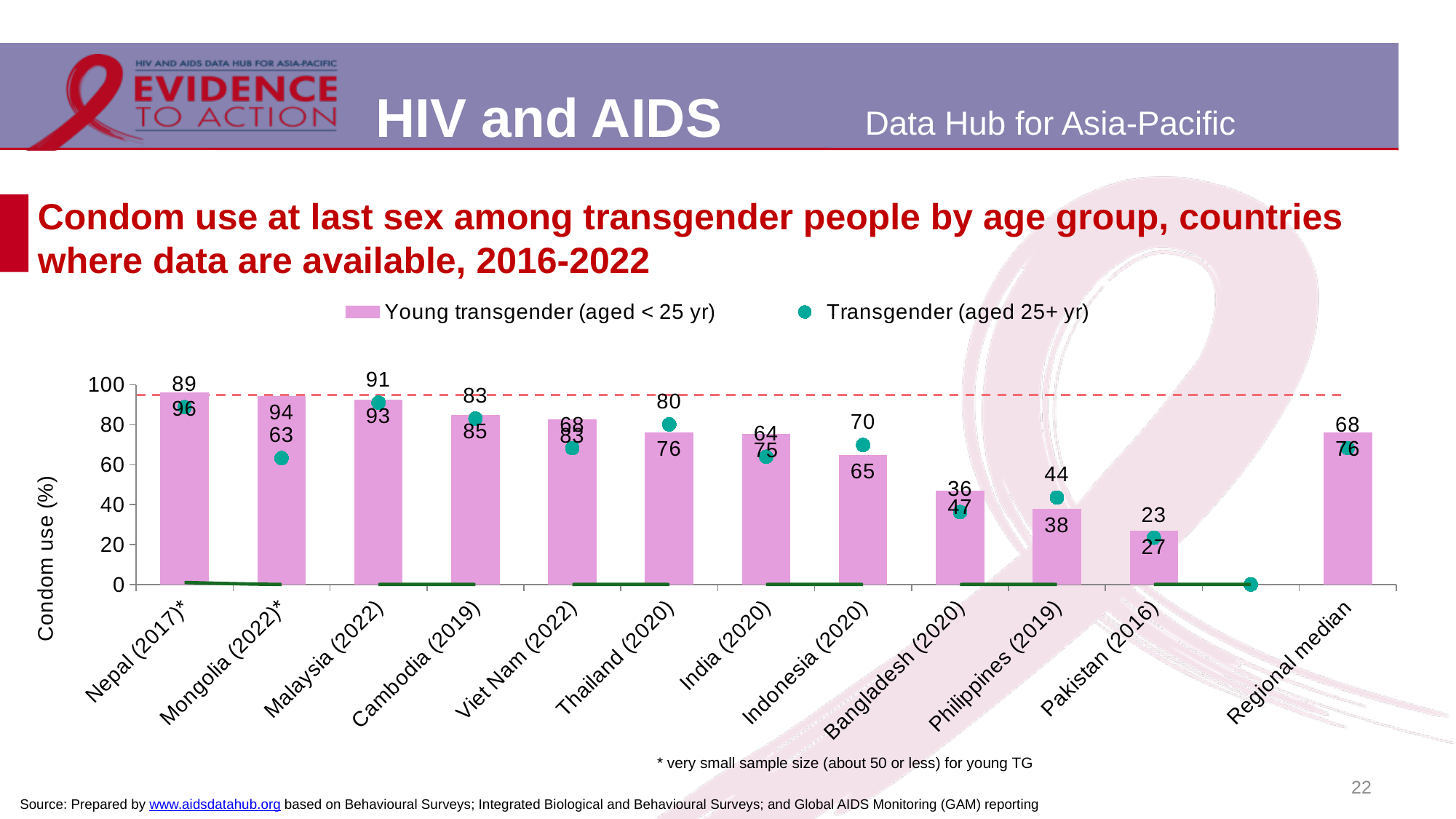
In the Philippines (2019), which is larger: the value for young transgender people (aged < 25 yr) or for transgender people aged 25+ yr? Transgender (aged 25+ yr) How many categories are labelled on the x axis of the chart? 12 What is the condom use value for transgender people aged 25+ yr in Thailand (2020)? 80 Which country has the highest condom use value for transgender people aged 25+ yr? Malaysia (2022) What is the condom use value for young transgender people (aged < 25 yr) in Mongolia (2022)? 94 What is the label of the y axis? Condom use (%) What is the Regional median value for transgender people aged 25+ yr? 68 What is the value for young transgender people (aged < 25 yr) in Bangladesh (2020)? 47 How many series does the legend list? 2 What is the difference between the young transgender (aged < 25 yr) value and the transgender (aged 25+ yr) value for Mongolia (2022)? 31 Which country has the lowest condom use value for young transgender people (aged < 25 yr)? Pakistan (2016) Is the value for young transgender people (aged < 25 yr) in Indonesia (2020) greater or less than 60? greater